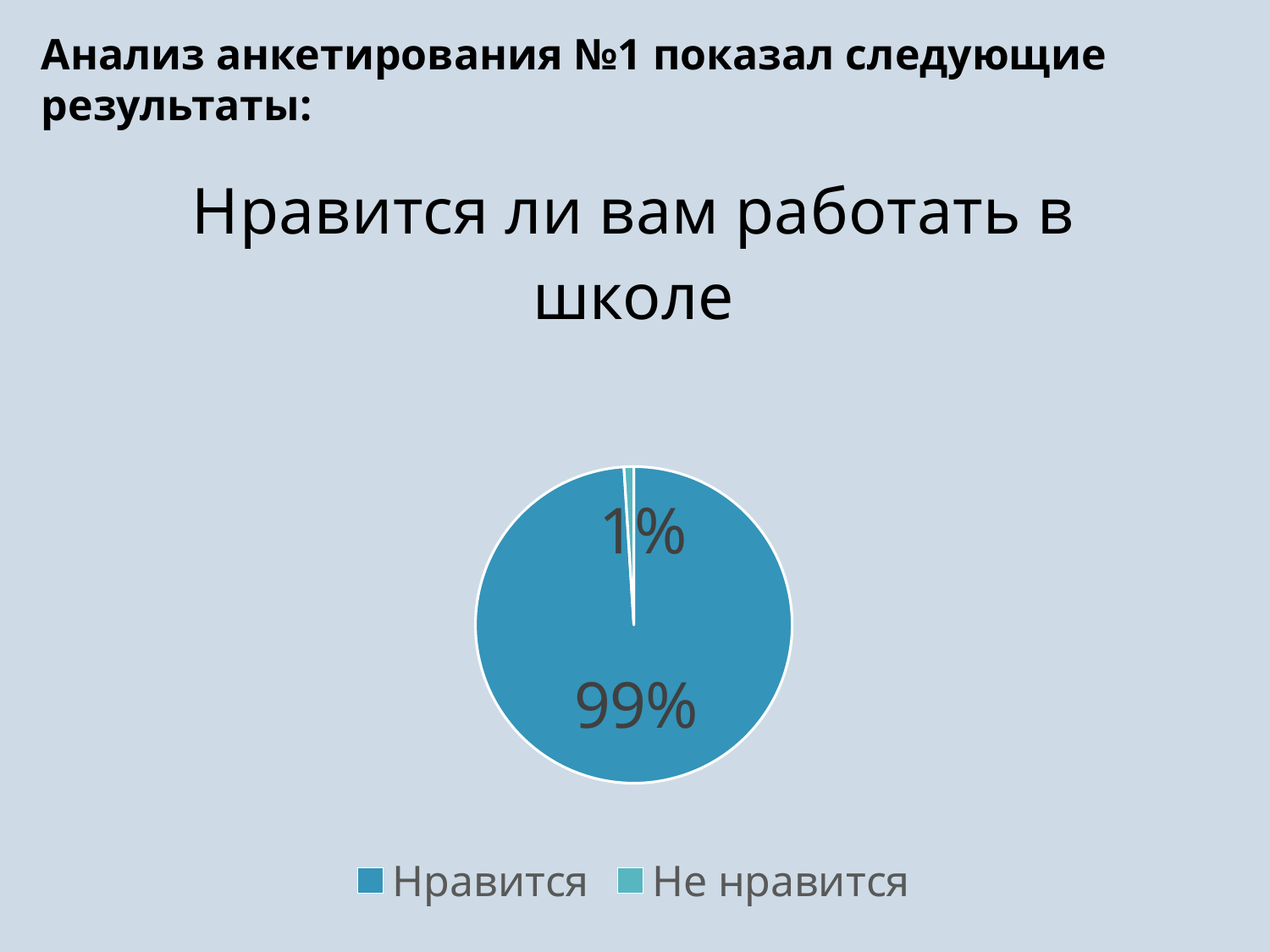
Which legend entry is listed first? Нравится Which category has the largest slice of the pie? Нравится Which is larger, the slice for "Нравится" or the slice for "Не нравится"? Нравится What is the title of the chart? Нравится ли вам работать в школе How many slices does the pie chart have? 2 What share of the pie does "Нравится" take? 99% What kind of chart is shown on the slide? pie chart How many categories does the legend list? 2 What is the difference in percentage points between "Нравится" and "Не нравится"? 98 percentage points What share of the pie does "Не нравится" take? 1% Which category has the smallest slice of the pie? Не нравится